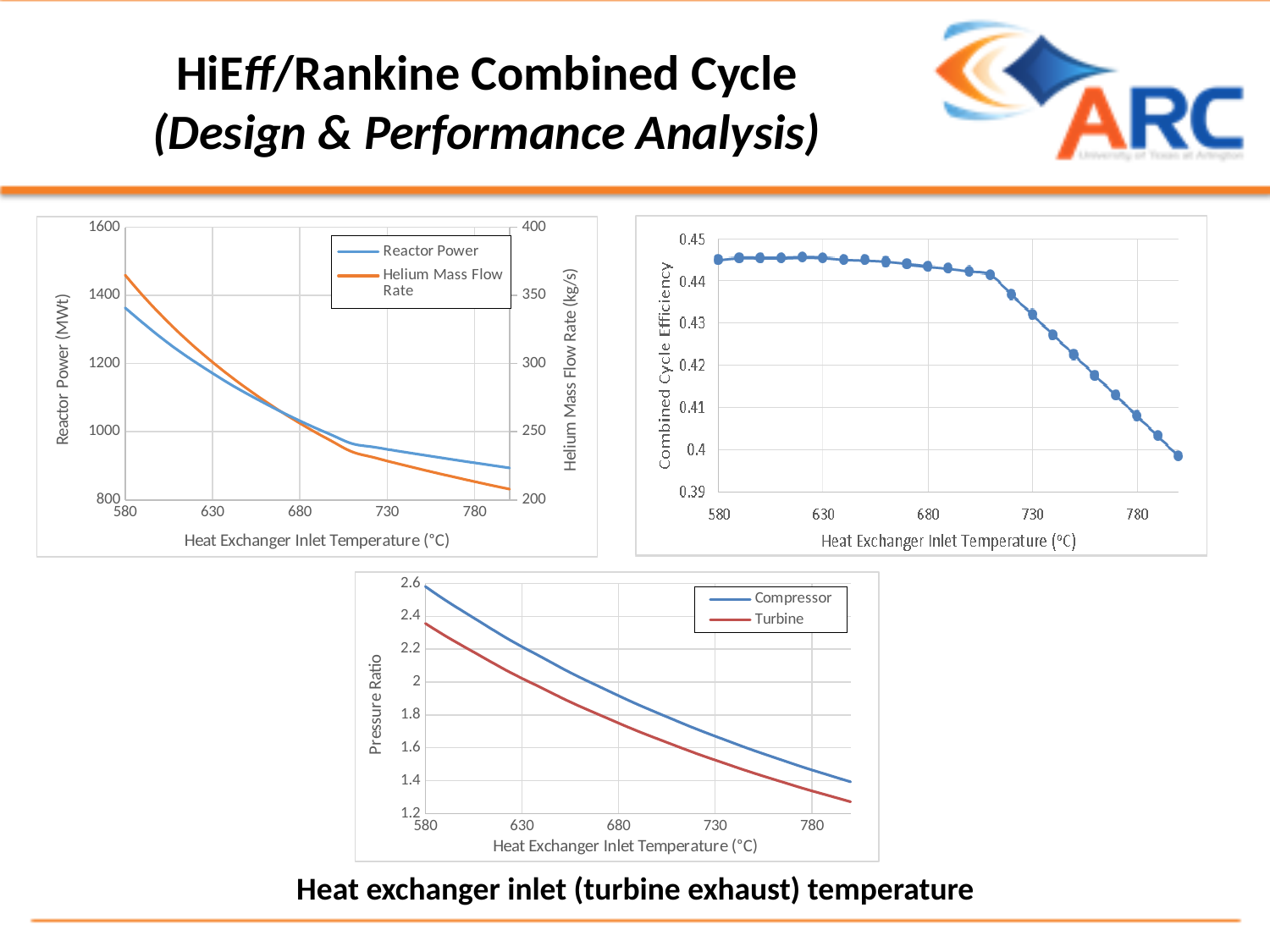
In the bottom chart, does the Compressor pressure ratio rise or fall as Heat Exchanger Inlet Temperature increases? fall In the top-left chart, does Reactor Power rise or fall as Heat Exchanger Inlet Temperature increases? fall How many series does the legend of the bottom Pressure Ratio chart list? 2 In the top-right chart, does Combined Cycle Efficiency rise or fall as Heat Exchanger Inlet Temperature increases from 580 to 800? fall In the top-right chart, is the Combined Cycle Efficiency at 580 °C greater or less than 0.44? greater In the bottom chart, is the Compressor pressure ratio at 580 °C greater or less than 2.4? greater In the top-left chart, is the Helium Mass Flow Rate at 580 °C greater or less than 350? greater In the bottom chart, which series has the higher pressure ratio at 680 °C, Compressor or Turbine? Compressor What is the x-axis title of the top-right chart? Heat Exchanger Inlet Temperature (°C) What kind of chart is the bottom chart showing Pressure Ratio? line chart How many series does the legend of the top-left chart list? 2